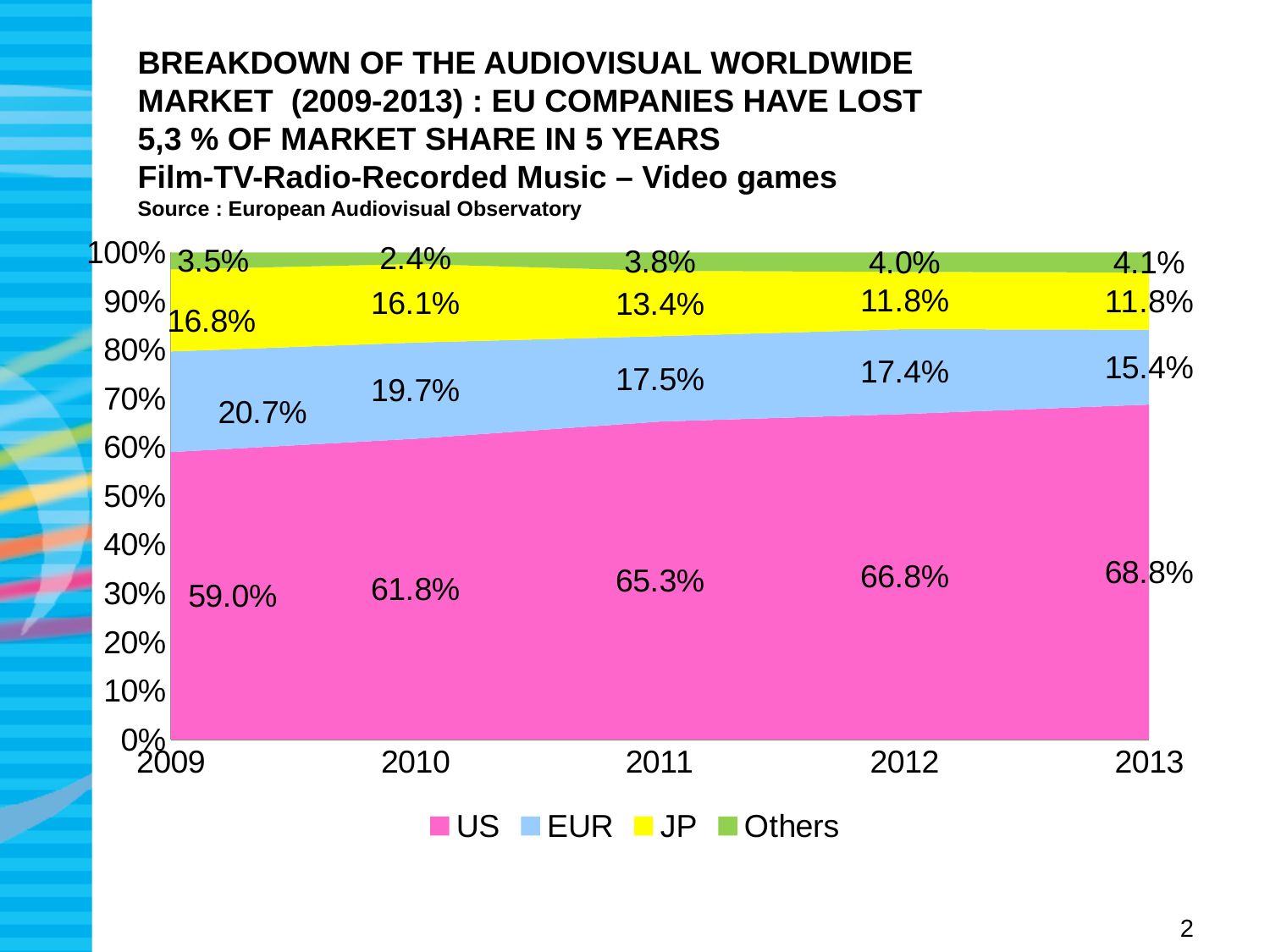
In which year is the Others share lowest? 2010 How many years are shown on the x axis? 5 How many series does the legend list? 4 By how many percentage points did the EUR share fall from 2009 to 2013? 5.3 Which is larger in 2012, the EUR share or the JP share? EUR Does the US share rise or fall from 2009 to 2013? Rise What kind of chart is shown on the slide? Stacked area chart What is the Others share in 2010? 2.4% What is the JP share in 2011? 13.4% In which year is the US share highest? 2013 What is the US share of the audiovisual worldwide market in 2009? 59.0% What is the EUR share in 2013? 15.4%